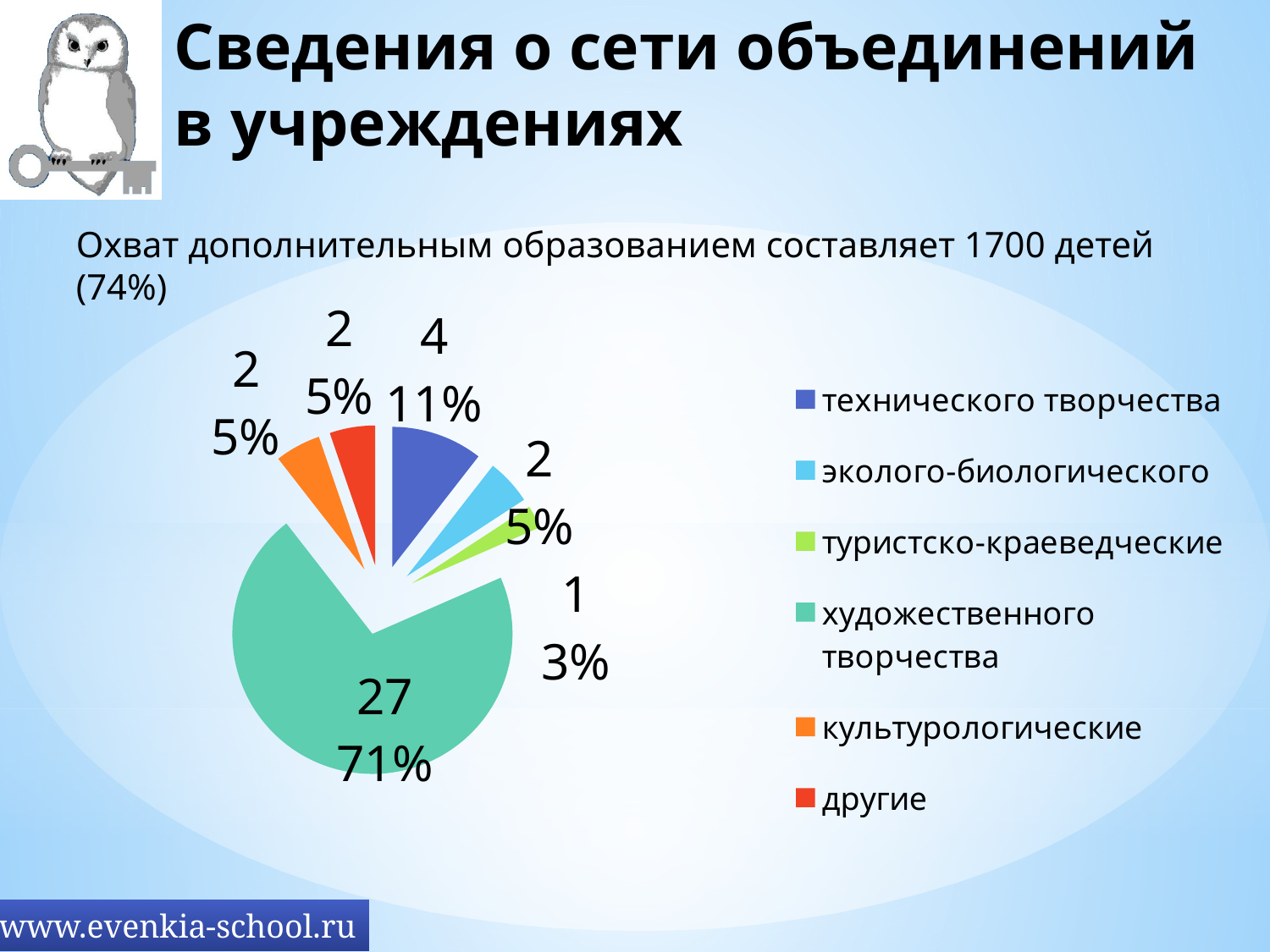
What share of the pie does технического творчества take? 11% What kind of chart is shown on the slide? pie chart What is the difference between the values for художественного творчества and технического творчества? 23 What colour is the slice for другие? red How many categories does the legend of the pie chart list? 6 Which is larger, the value for технического творчества or the value for культурологические? технического творчества What is the value shown for технического творчества? 4 Which category has the smallest slice of the pie? туристско-краеведческие What share of the pie does художественного творчества take? 71% What is the value shown for художественного творчества? 27 Which category has the largest slice of the pie? художественного творчества What is the value shown for туристско-краеведческие? 1